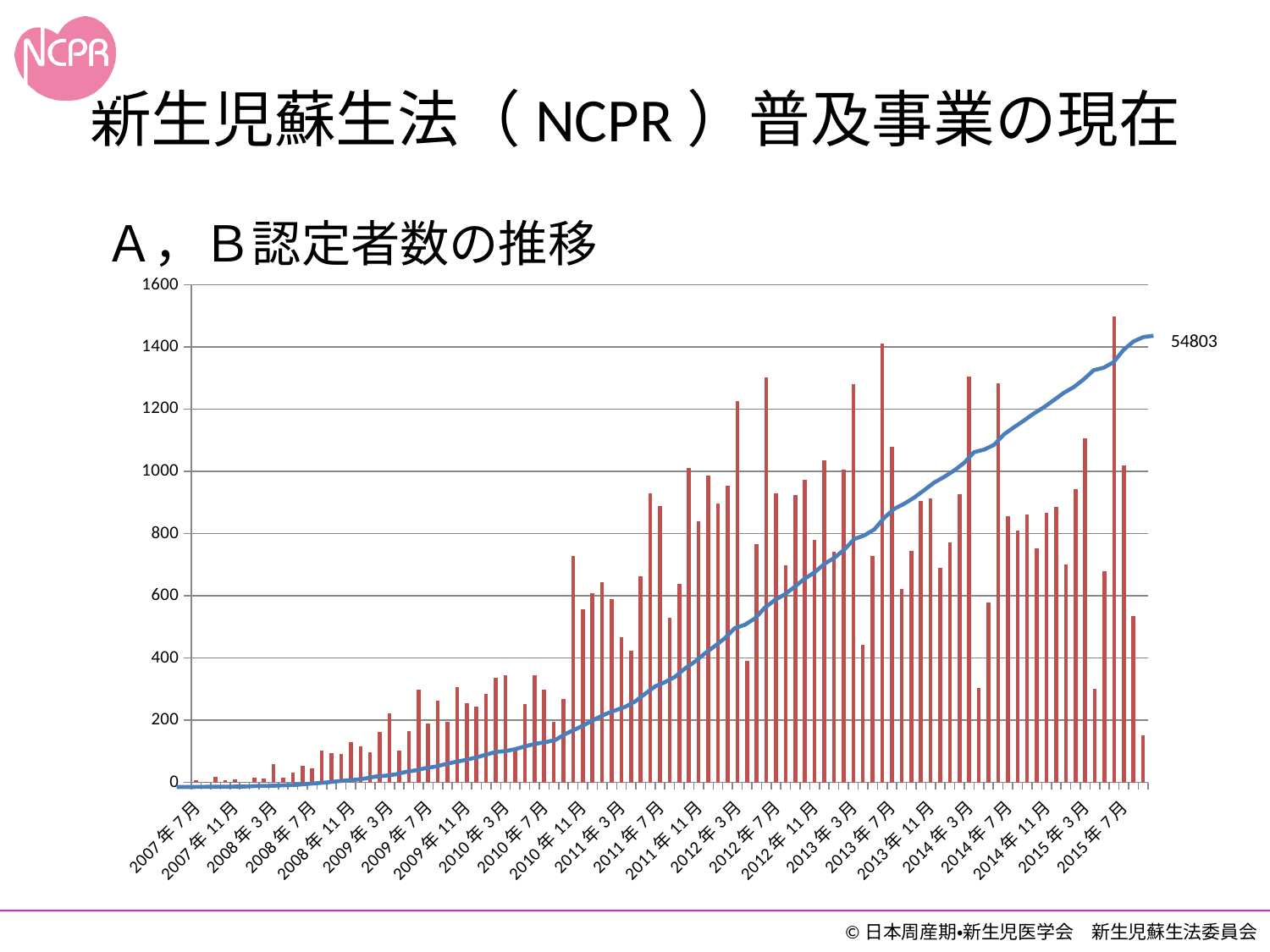
Is the tallest red bar greater or less than 1400? greater What kind of chart is shown on the slide? A bar chart combined with a line What is the title of the chart? A，B認定者数の推移 Is the red bar for 2008年3月 greater or less than 200? less Is the red bar for 2007年7月 greater or less than 200? less What is the first label on the x axis? 2007年7月 Does the blue line rise or fall from left to right along the x axis? It rises Which red bar is larger, the one for 2007年7月 or the one for 2015年7月? 2015年7月 What value is printed as the data label at the right end of the blue line? 54803